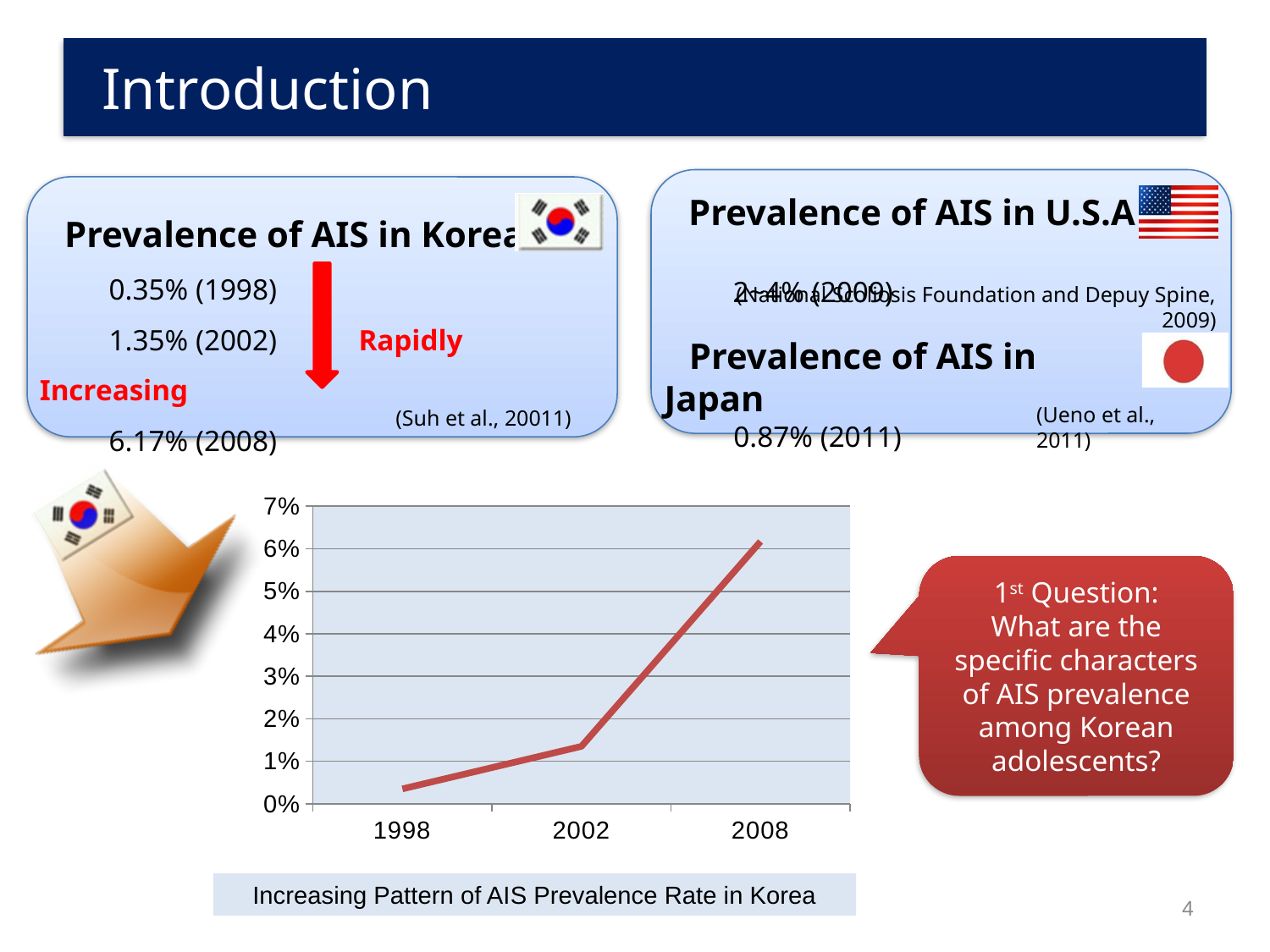
Is the value for 2008 on the chart greater or less than 5%? greater What kind of chart is shown on the slide? line chart How many data points are plotted on the line chart? 3 Which year has the lowest AIS prevalence rate on the chart? 1998 Is the value for 1998 on the chart greater or less than 1%? less Is the value for 2002 on the chart greater or less than 2%? less According to the slide, what was the AIS prevalence rate in Korea in 1998? 0.35% Which year has the highest AIS prevalence rate on the chart? 2008 What is the caption below the chart? Increasing Pattern of AIS Prevalence Rate in Korea Does the AIS prevalence rate rise or fall from 1998 to 2008 on the chart? rise According to the slide, what was the AIS prevalence rate in Korea in 2008? 6.17% Which is larger on the chart, the value for 2002 or the value for 2008? 2008